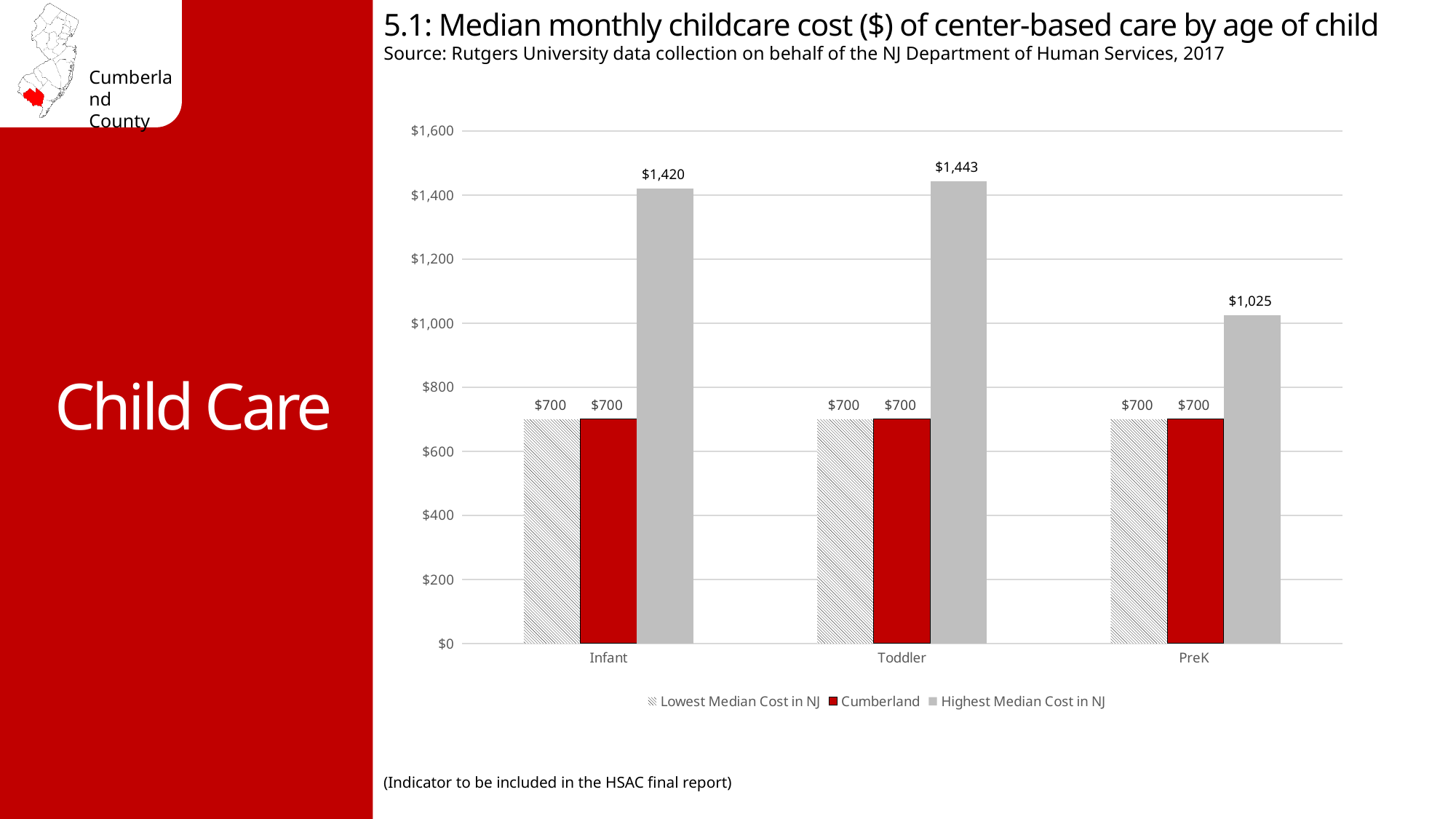
What kind of chart is shown on the slide? Bar chart What is the difference between the Highest Median Cost in NJ for Toddler and for PreK? $418 What is the Highest Median Cost in NJ for Infant care? $1,420 Which age group has the lowest value for Highest Median Cost in NJ? PreK How many age groups are shown on the x axis? 3 What is the difference between the Highest Median Cost in NJ and the Cumberland cost for Infant care? $720 What is the Highest Median Cost in NJ for PreK care? $1,025 Which age group has the highest value for Highest Median Cost in NJ? Toddler How many series does the legend list? 3 Which is larger: the Highest Median Cost in NJ for Infant or for PreK? Infant What is the Highest Median Cost in NJ for Toddler care? $1,443 What is the Cumberland median monthly cost for Toddler care? $700